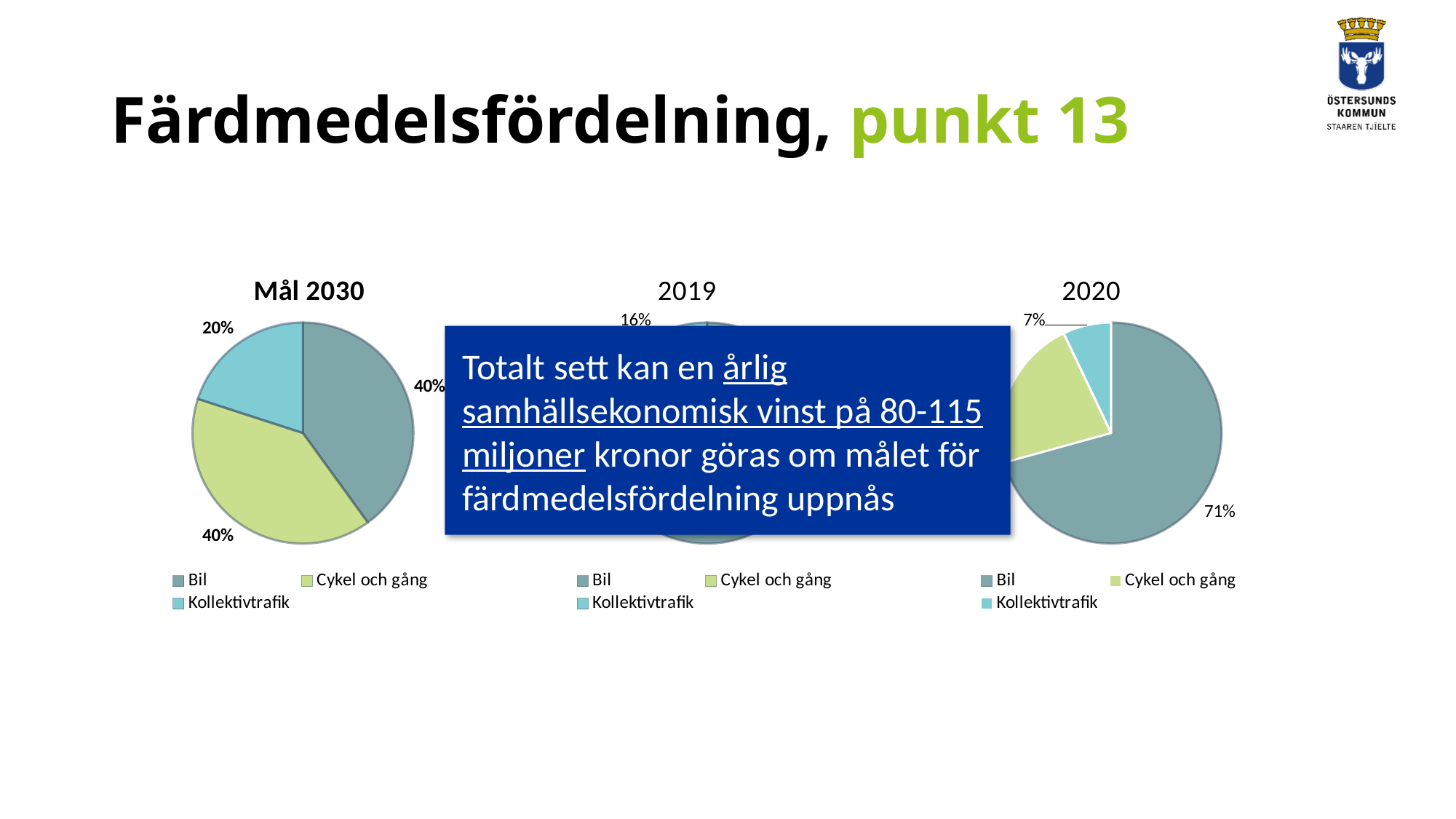
In the "Mål 2030" chart, what share is Kollektivtrafik? 20% What kind of chart is the "Mål 2030" chart? Pie chart How many categories does the legend of the "2020" chart list? 3 In the "Mål 2030" chart, what share is Bil? 40% In the "Mål 2030" chart, which is larger, Bil or Kollektivtrafik? Bil In the "Mål 2030" chart, which category has the smallest slice? Kollektivtrafik Is the Bil share larger in the "2020" chart or in the "Mål 2030" chart? 2020 In the "2020" chart, what is the difference between the Bil share and the Kollektivtrafik share? 64 percentage points In the "2020" chart, what share is Kollektivtrafik? 7% In the "2020" chart, which category has the largest slice? Bil In the "2020" chart, what share is Bil? 71% In the "2020" chart, which category has the smallest slice? Kollektivtrafik